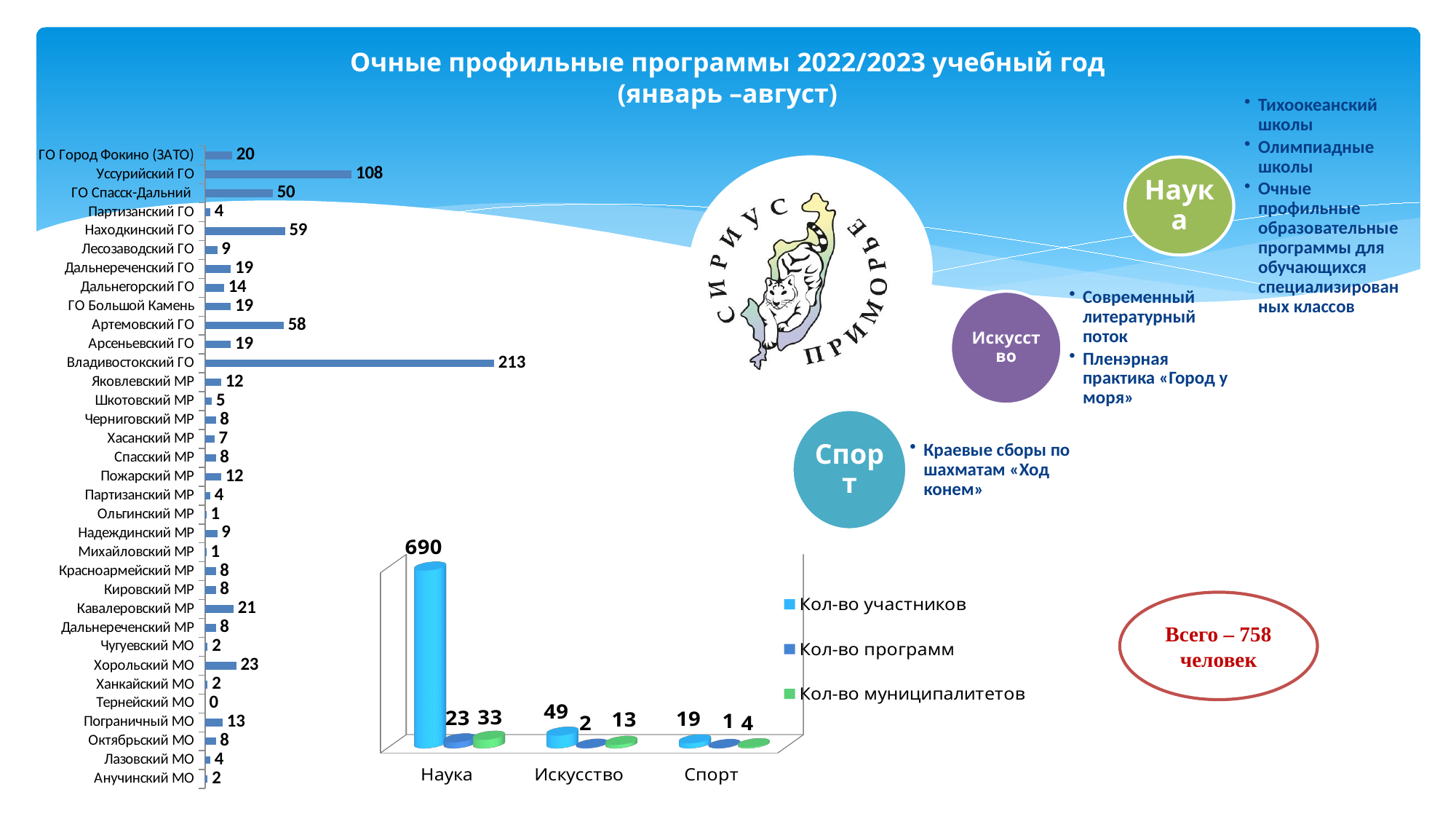
In the left bar chart of municipalities, which is larger: the value for Хорольский МО or the value for Кавалеровский МР? Хорольский МО In the bottom chart with Наука, Искусство and Спорт, what is the difference between Кол-во участников for Искусство and for Спорт? 30 In the left bar chart of municipalities, which municipality has the lowest value? Тернейский МО What kind of chart is the chart on the left listing municipalities? Bar chart In the left bar chart of municipalities, what is the difference between the values for Находкинский ГО and Артемовский ГО? 1 In the left bar chart of municipalities, what is the value for Владивостокский ГО? 213 In the left bar chart of municipalities, what is the value for Уссурийский ГО? 108 In the bottom chart with Наука, Искусство and Спорт, how many series does the legend list? 3 In the bottom chart with Наука, Искусство and Спорт, what is the value of Кол-во участников for Наука? 690 In the bottom chart with Наука, Искусство and Спорт, what is the value of Кол-во муниципалитетов for Искусство? 13 In the left bar chart of municipalities, how many municipalities are listed? 34 In the left bar chart of municipalities, which municipality has the highest value? Владивостокский ГО